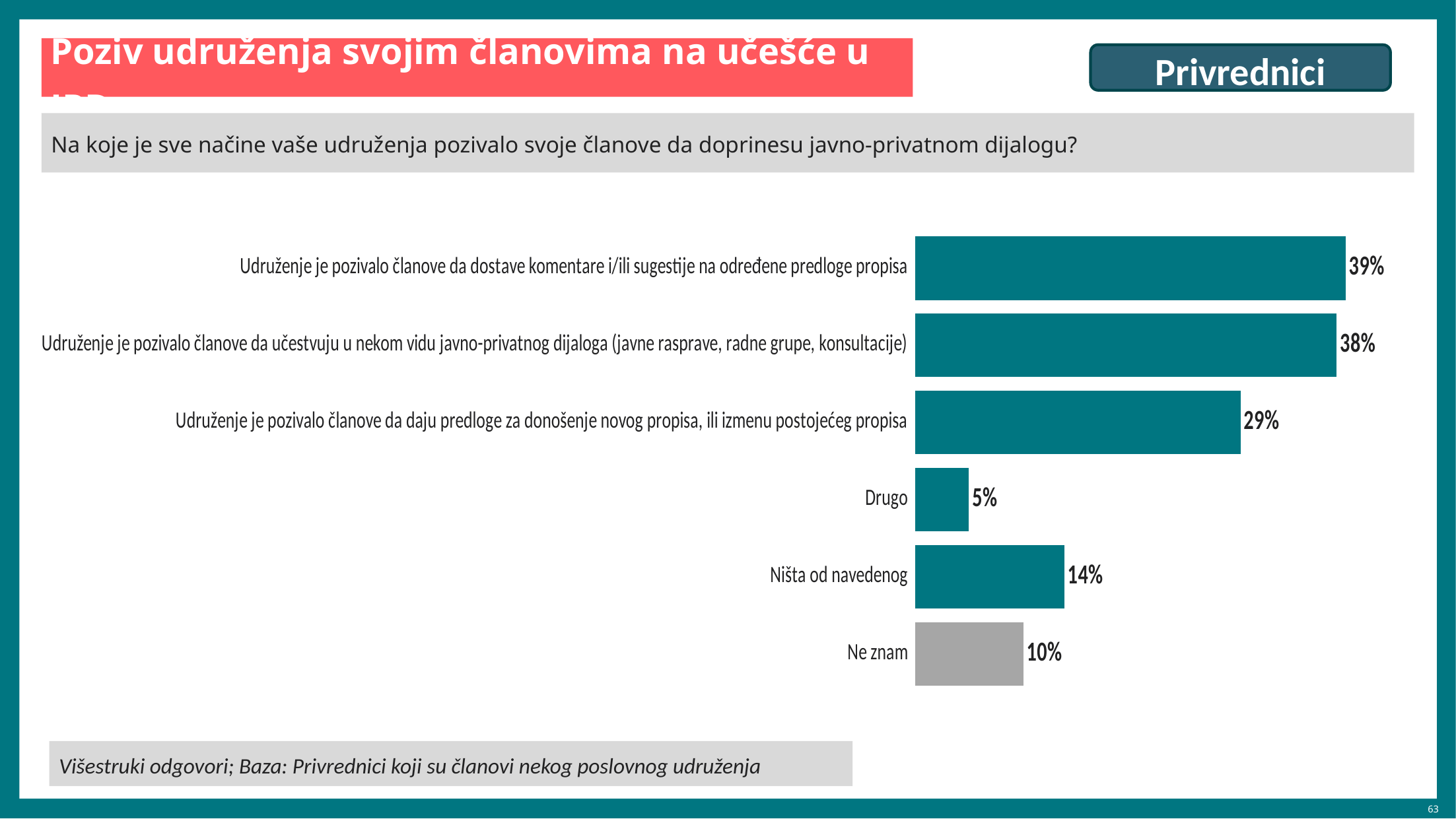
How many categories are shown in the chart? 6 What is the difference in percentage points between the highest category (39%) and "Udruženje je pozivalo članove da daju predloge za donošenje novog propisa, ili izmenu postojećeg propisa"? 10 Which category has the highest value? Udruženje je pozivalo članove da dostave komentare i/ili sugestije na određene predloge propisa What is the difference in percentage points between "Ništa od navedenog" and "Ne znam"? 4 Which is larger, the value for "Ništa od navedenog" or the value for "Ne znam"? Ništa od navedenog What is the value for "Ništa od navedenog"? 14% What is the value for "Ne znam"? 10% What kind of chart is shown on the slide? Bar chart What percentage is shown for "Udruženje je pozivalo članove da učestvuju u nekom vidu javno-privatnog dijaloga (javne rasprave, radne grupe, konsultacije)"? 38% Which category has the lowest value? Drugo What percentage is shown for "Udruženje je pozivalo članove da daju predloge za donošenje novog propisa, ili izmenu postojećeg propisa"? 29% What is the value for "Drugo"? 5%